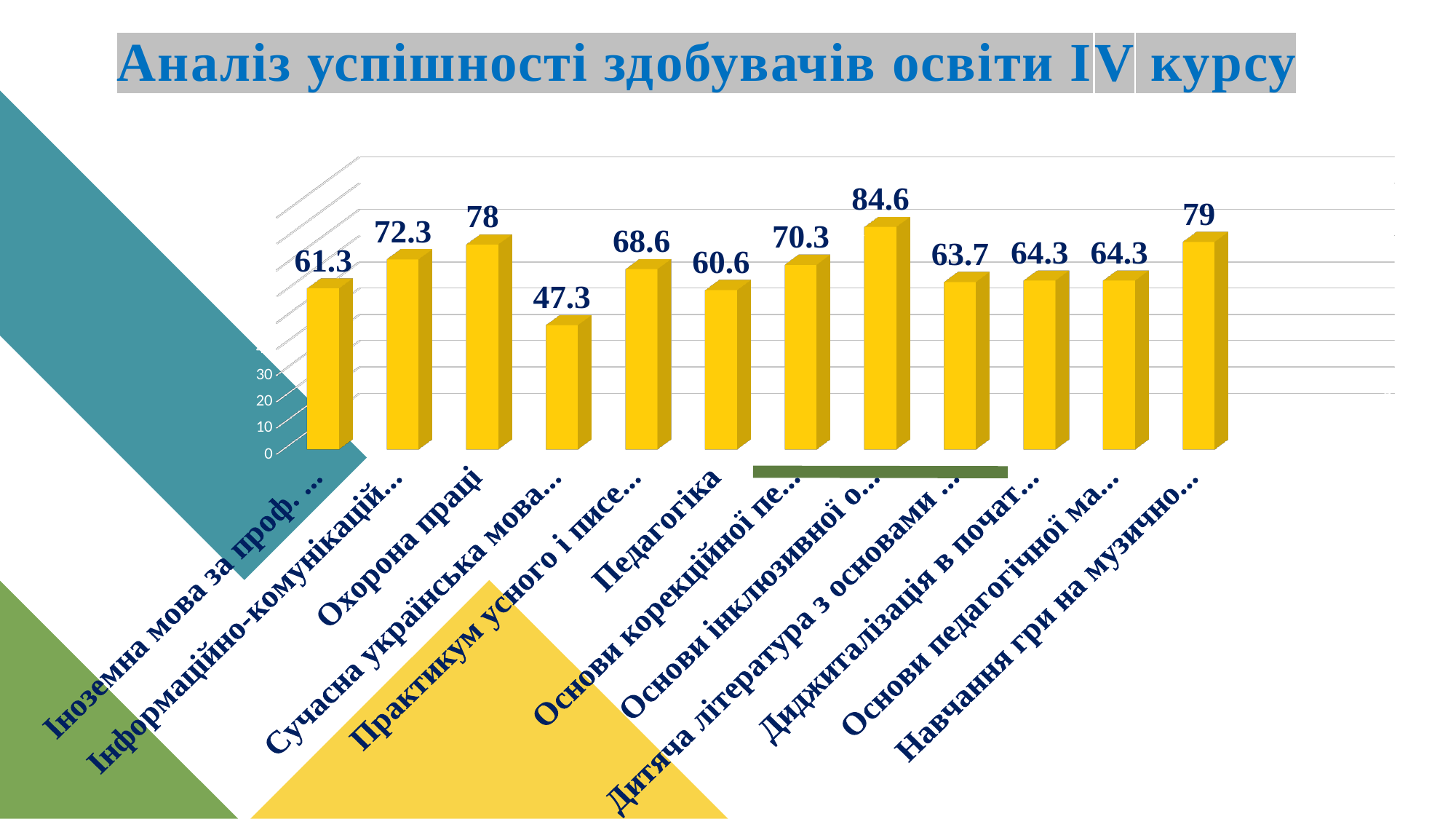
How many bars have the value 64.3? 2 What is the value for Охорона праці? 78 What type of chart is shown on the slide? bar chart Which has a larger value, Охорона праці or Педагогіка? Охорона праці How many bars are plotted in the chart? 12 Is the value for Педагогіка greater or less than 30? greater What is the value for Педагогіка? 60.6 What is the difference between the values for Охорона праці and Педагогіка? 17.4 What colour are the bars in the chart? yellow What is the lowest value shown in the chart? 47.3 What is the title of the slide? Аналіз успішності здобувачів освіти IV курсу What is the highest value shown in the chart? 84.6